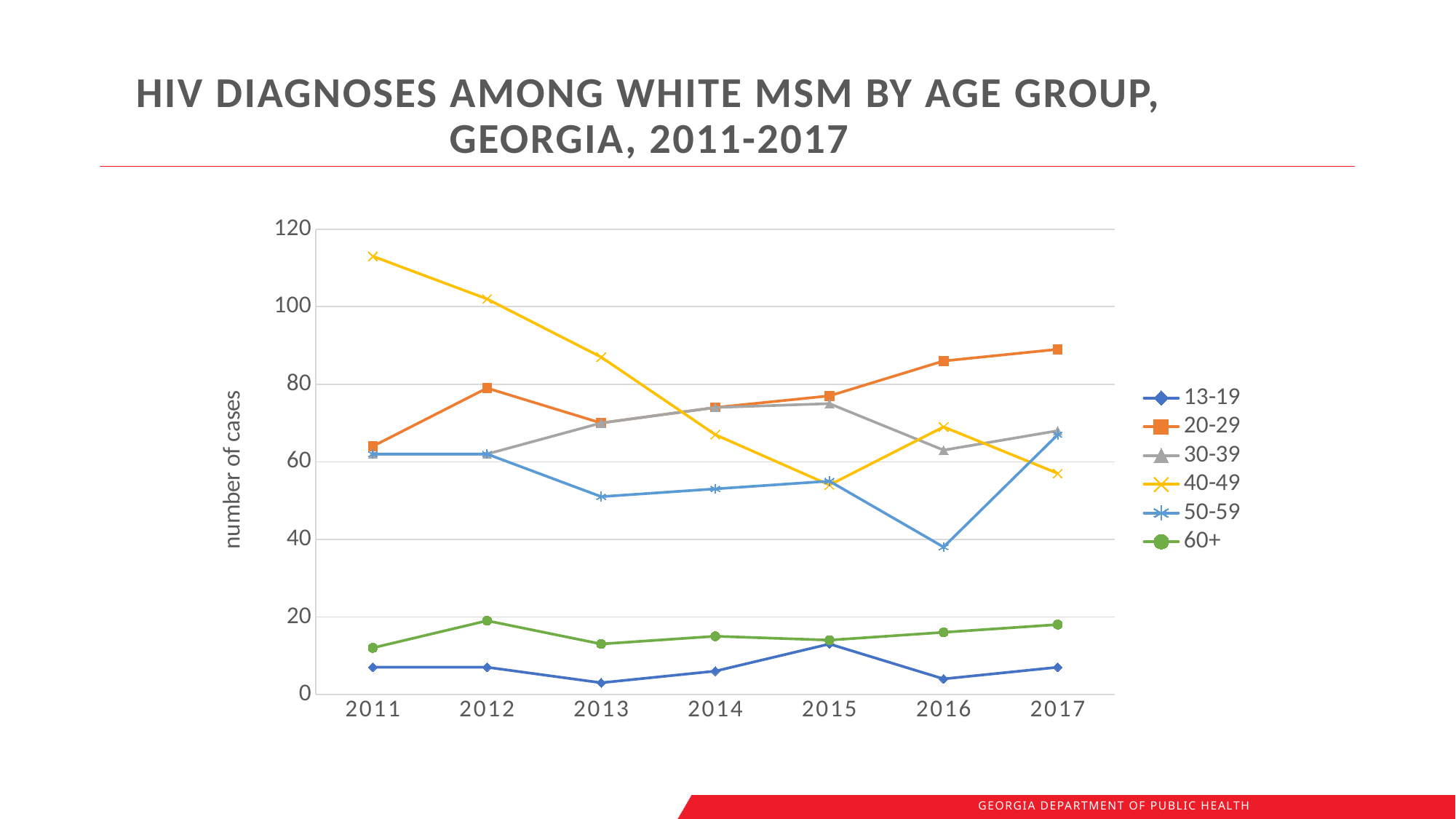
Which age group had the lowest number of cases in 2017? 13-19 How many years are shown on the x axis? 7 In 2012, which had more cases: the 20-29 age group or the 30-39 age group? 20-29 Which age group had the highest number of cases in 2017? 20-29 What is the label on the y axis? number of cases How many age groups does the legend list? 6 Is the value for the 13-19 age group in 2013 greater or less than 20? less Did the number of cases for the 40-49 age group rise or fall from 2011 to 2015? fall Is the value for the 40-49 age group in 2011 greater or less than 100? greater Is the value for the 50-59 age group in 2016 greater or less than 60? less Which age group had the highest number of cases in 2011? 40-49 What kind of chart is shown on the slide? line chart